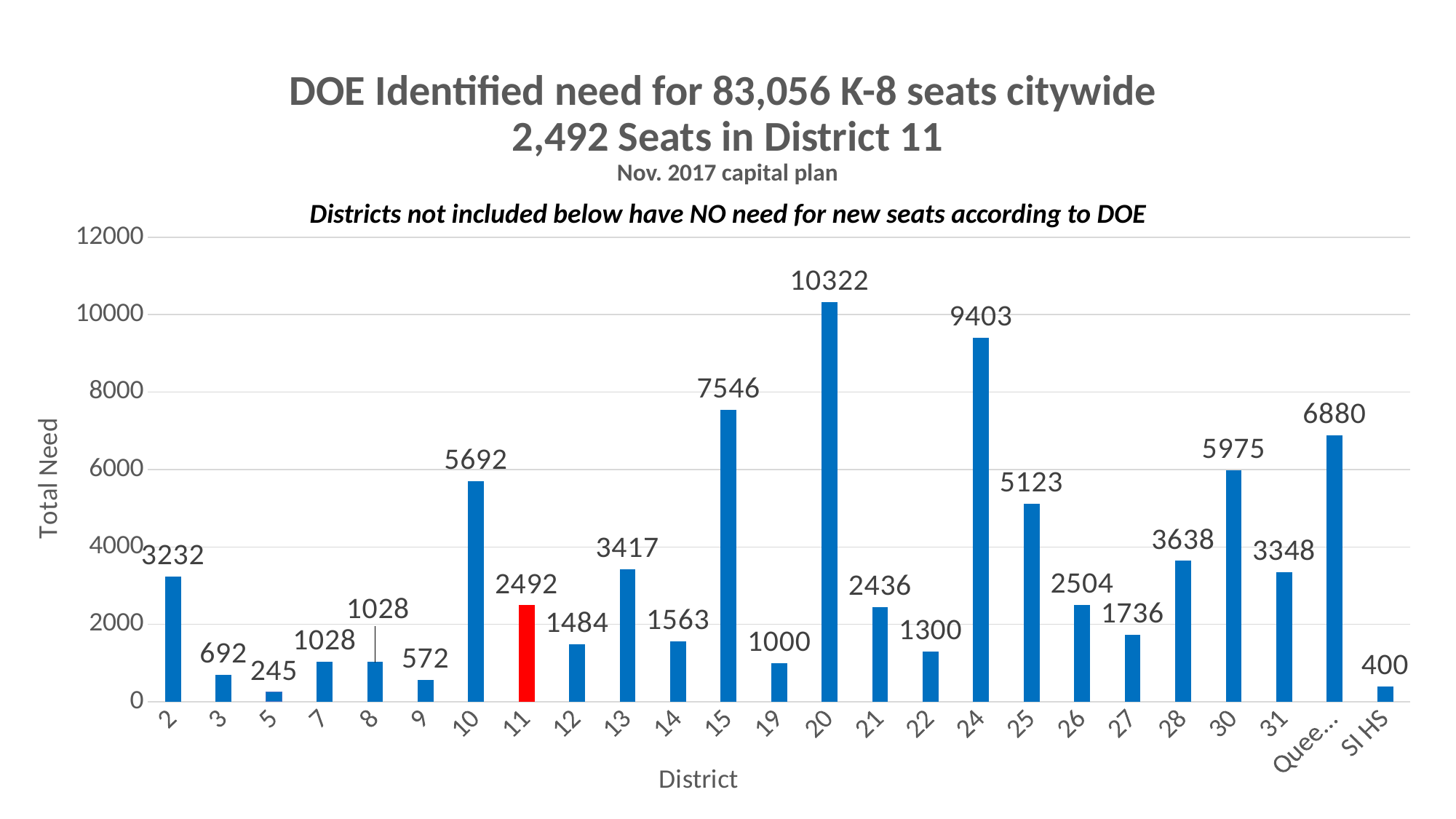
Which district has the highest total need? 20 How many districts are shown on the x axis? 25 What is the difference in total need between District 20 and District 24? 919 Is the value for District 10 greater or less than 4000? greater Which district's bar is coloured red? 11 What is the total need for District 20? 10322 Which has a larger total need, District 15 or District 30? District 15 What is the total need for SI HS? 400 What is the total need for District 11? 2492 What kind of chart is shown on the slide? bar chart Which district has the lowest total need? 5 What is the difference in total need between District 11 and District 12? 1008